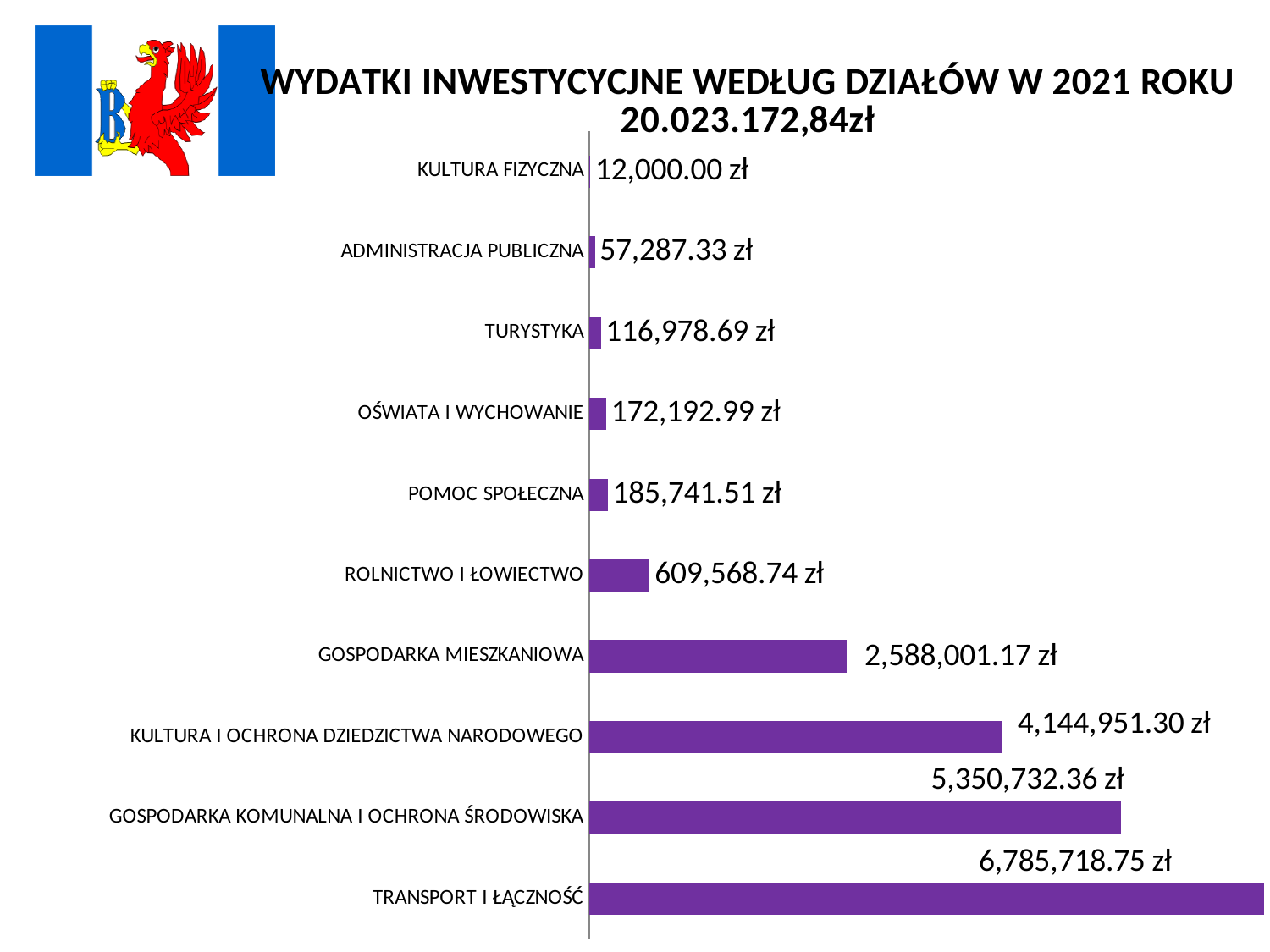
How many categories (działy) are shown in the chart? 10 Which category has the highest investment expenditure? TRANSPORT I ŁĄCZNOŚĆ What is the difference between the values for POMOC SPOŁECZNA and OŚWIATA I WYCHOWANIE? 13,548.52 zł What is the value for TURYSTYKA? 116,978.69 zł What is the value for GOSPODARKA MIESZKANIOWA? 2,588,001.17 zł What is the value for ROLNICTWO I ŁOWIECTWO? 609,568.74 zł What kind of chart is shown on the slide? bar chart What is the difference between the values for TRANSPORT I ŁĄCZNOŚĆ and GOSPODARKA KOMUNALNA I OCHRONA ŚRODOWISKA? 1,434,986.39 zł What is the title of the chart? WYDATKI INWESTYCYCJNE WEDŁUG DZIAŁÓW W 2021 ROKU 20.023.172,84zł Which is larger, the value for KULTURA I OCHRONA DZIEDZICTWA NARODOWEGO or the value for GOSPODARKA MIESZKANIOWA? KULTURA I OCHRONA DZIEDZICTWA NARODOWEGO Which category has the lowest investment expenditure? KULTURA FIZYCZNA What is the value for TRANSPORT I ŁĄCZNOŚĆ? 6,785,718.75 zł